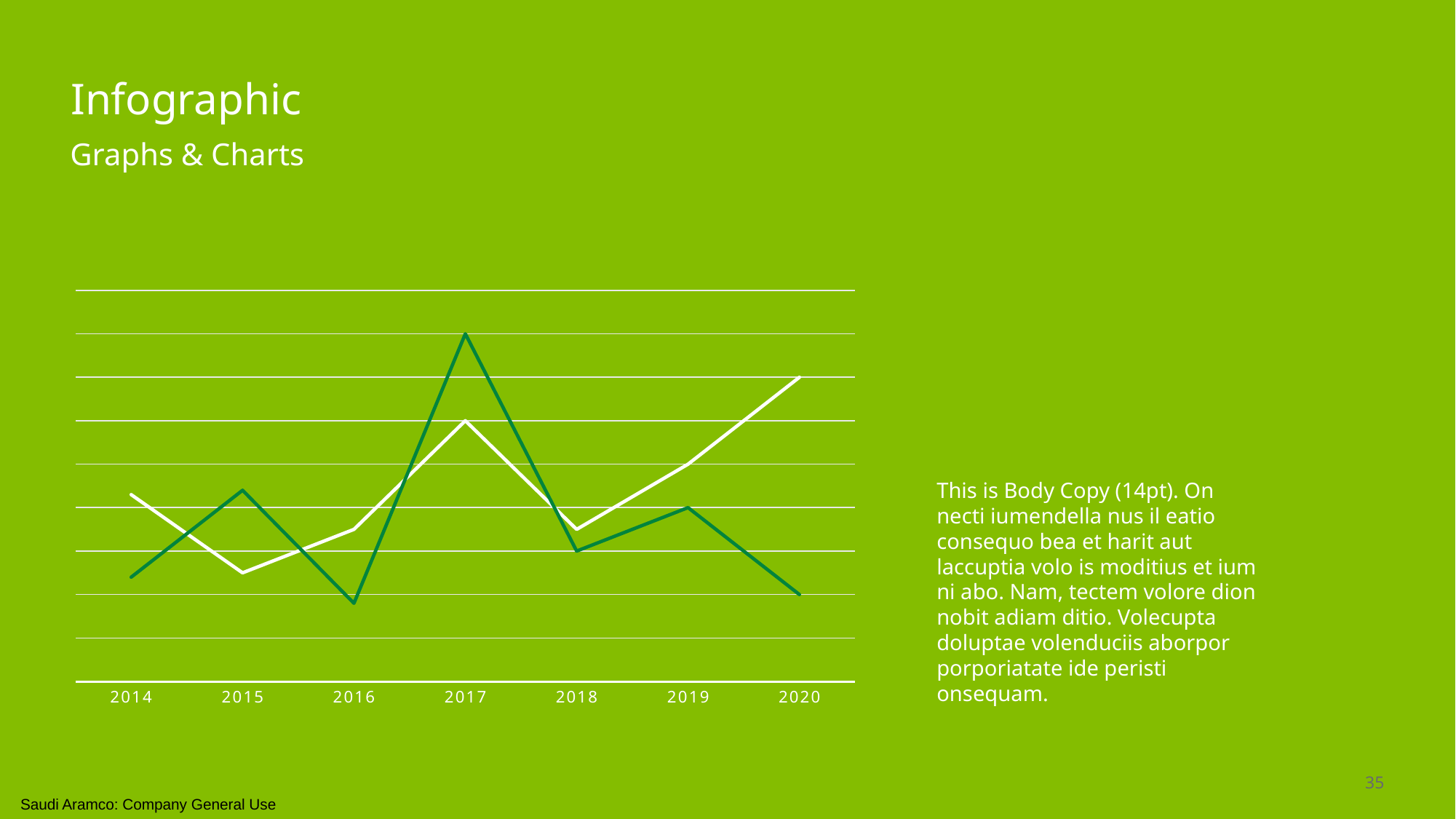
Does the dark green line rise or fall from 2017 to 2018? Fall What kind of chart is shown on the slide? Line chart How many years are shown on the x axis of the chart? 7 In which year does the white line reach its lowest point? 2015 How many lines are plotted on the chart? 2 In which year does the dark green line reach its highest point? 2017 In 2014, which line is higher, the white line or the dark green line? White line Does the white line rise or fall from 2018 to 2020? Rise In 2020, which line is higher, the white line or the dark green line? White line In 2017, which line is higher, the white line or the dark green line? Dark green line What is the first year shown on the x axis of the chart? 2014 In which year does the white line reach its highest point? 2020